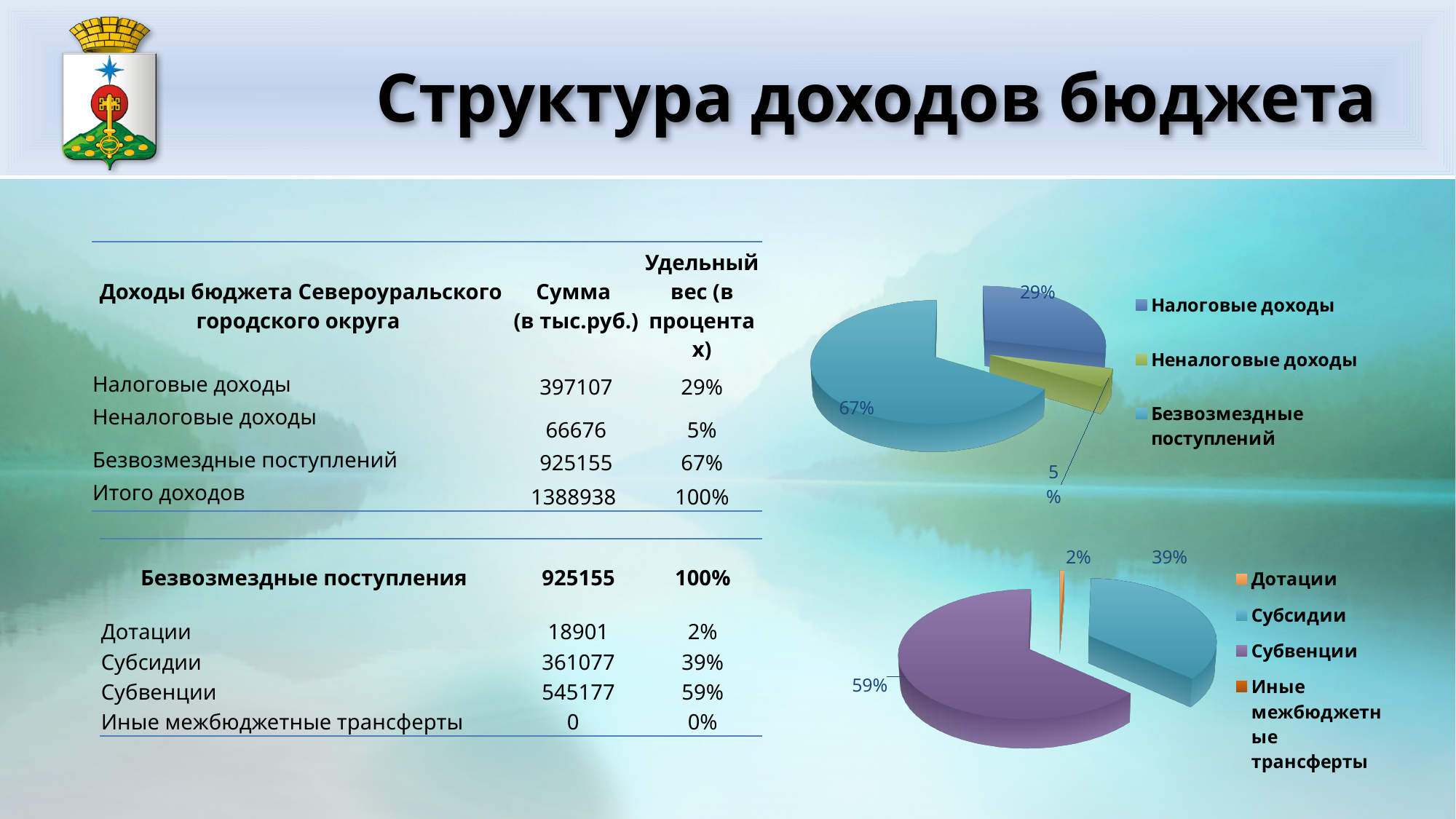
In the bottom pie chart, what share is shown for Дотации? 2% In the bottom pie chart, what share is shown for Субсидии? 39% In the top pie chart, what is the difference in percentage points between Безвозмездные поступлений and Налоговые доходы? 38 In the top pie chart, what share is shown for Налоговые доходы? 29% In the top pie chart, what share is shown for Неналоговые доходы? 5% In the top pie chart, which category has the smallest slice? Неналоговые доходы How many entries does the legend of the bottom pie chart list? 4 What type of chart is used for the top chart on the slide? Pie chart In the top pie chart, which category has the largest slice? Безвозмездные поступлений In the bottom pie chart, what share is shown for Субвенции? 59% In the top pie chart, what share is shown for Безвозмездные поступлений? 67% In the bottom pie chart, which is larger, Субсидии or Субвенции? Субвенции